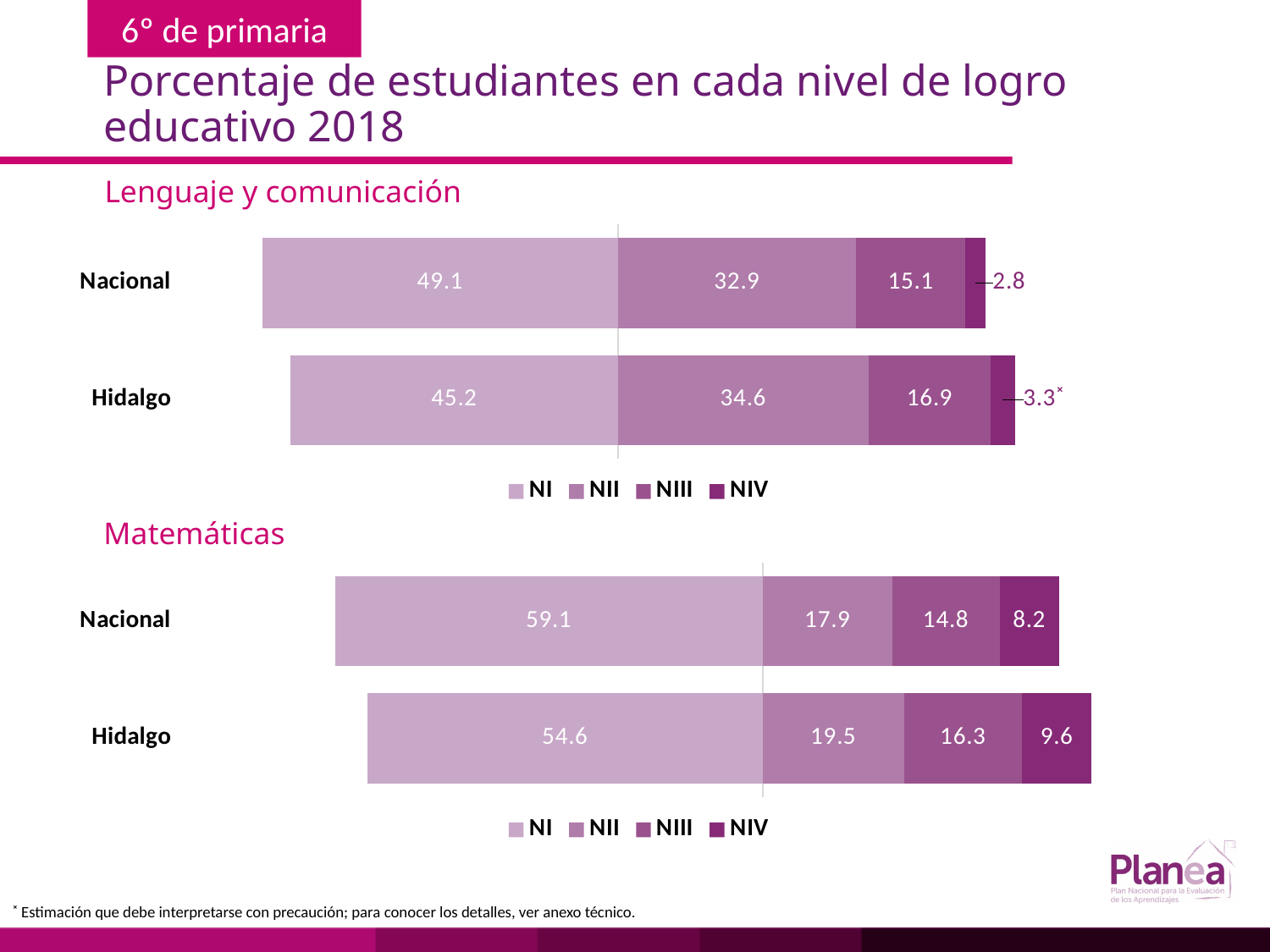
In the Matemáticas chart, what is the NIII value for Nacional? 14.8 In the Matemáticas chart, what is the difference between the NIV values for Hidalgo and Nacional? 1.4 In the Lenguaje y comunicación chart, what is the NIV value for Hidalgo? 3.3 In the Lenguaje y comunicación chart, what is the difference between the NI values for Nacional and Hidalgo? 3.9 In the Matemáticas chart, which level has the lowest value for Nacional? NIV How many series does the legend of the Lenguaje y comunicación chart list? 4 In the Matemáticas chart, what is the NII value for Hidalgo? 19.5 In the Matemáticas chart, which is larger: the NI value for Nacional or the NI value for Hidalgo? Nacional In the Matemáticas chart, what is the total of the stacked bar for Hidalgo? 100.0 In the Lenguaje y comunicación chart, what is the NI value for Nacional? 49.1 In the Lenguaje y comunicación chart, which level has the highest value for Hidalgo? NI What kind of chart is the Matemáticas chart? Stacked bar chart